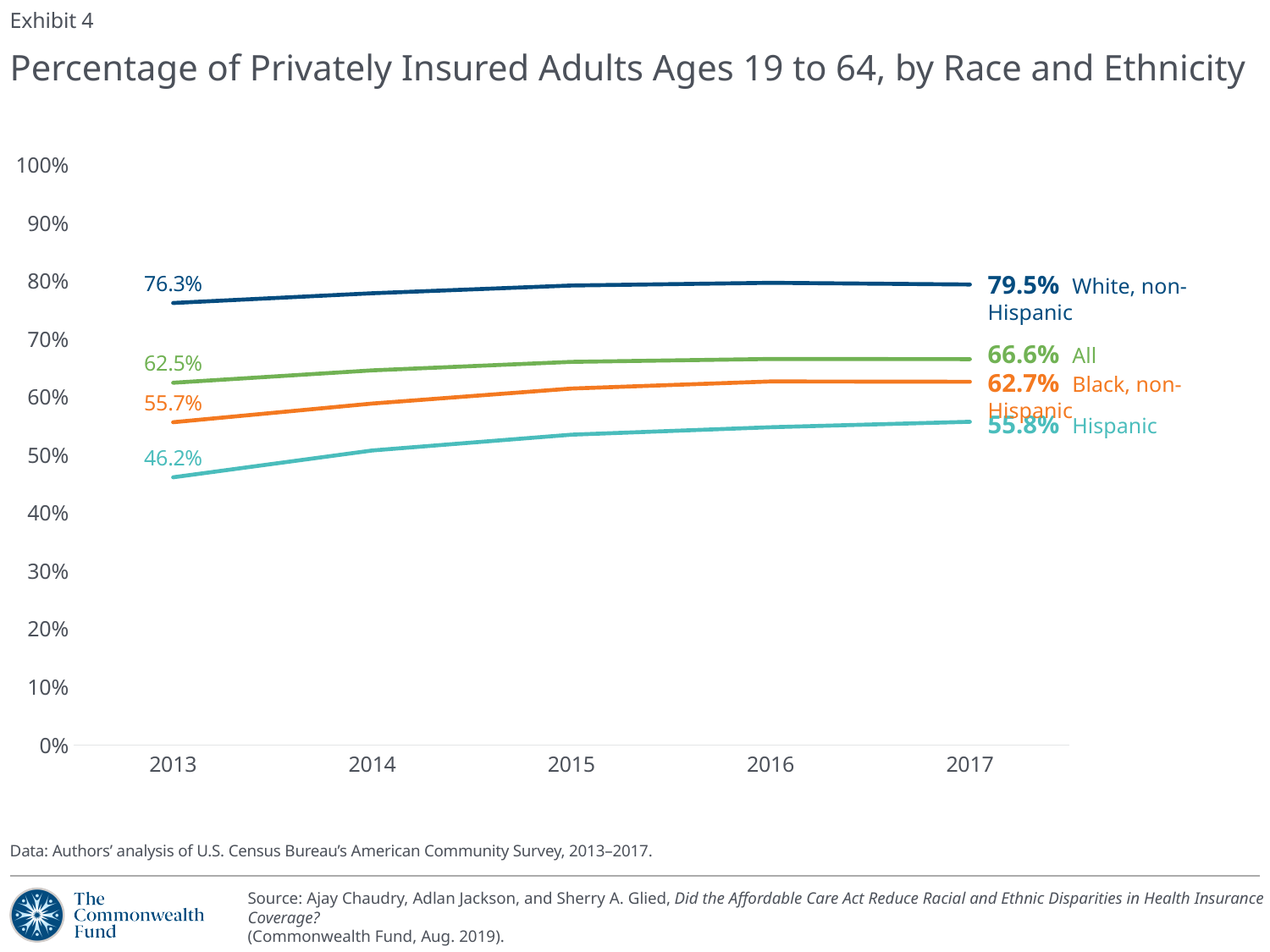
Which group had the lowest percentage of privately insured adults in 2013? Hispanic Which was larger in 2013: the rate for Black, non-Hispanic adults or the rate for Hispanic adults? Black, non-Hispanic What was the value for All adults in 2013? 62.5% Did the percentage of privately insured Hispanic adults rise or fall from 2013 to 2017? Rise What type of chart is shown on the slide? Line chart What is the difference between the White, non-Hispanic and Black, non-Hispanic rates in 2017? 16.8 percentage points Which group had the highest percentage of privately insured adults in 2017? White, non-Hispanic What was the percentage of privately insured Black, non-Hispanic adults in 2017? 62.7% What was the percentage of privately insured Hispanic adults in 2017? 55.8% What was the percentage of privately insured White, non-Hispanic adults in 2013? 76.3% By how many percentage points did the Hispanic rate change from 2013 to 2017? 9.6 percentage points How many series (groups) are plotted on the chart? 4